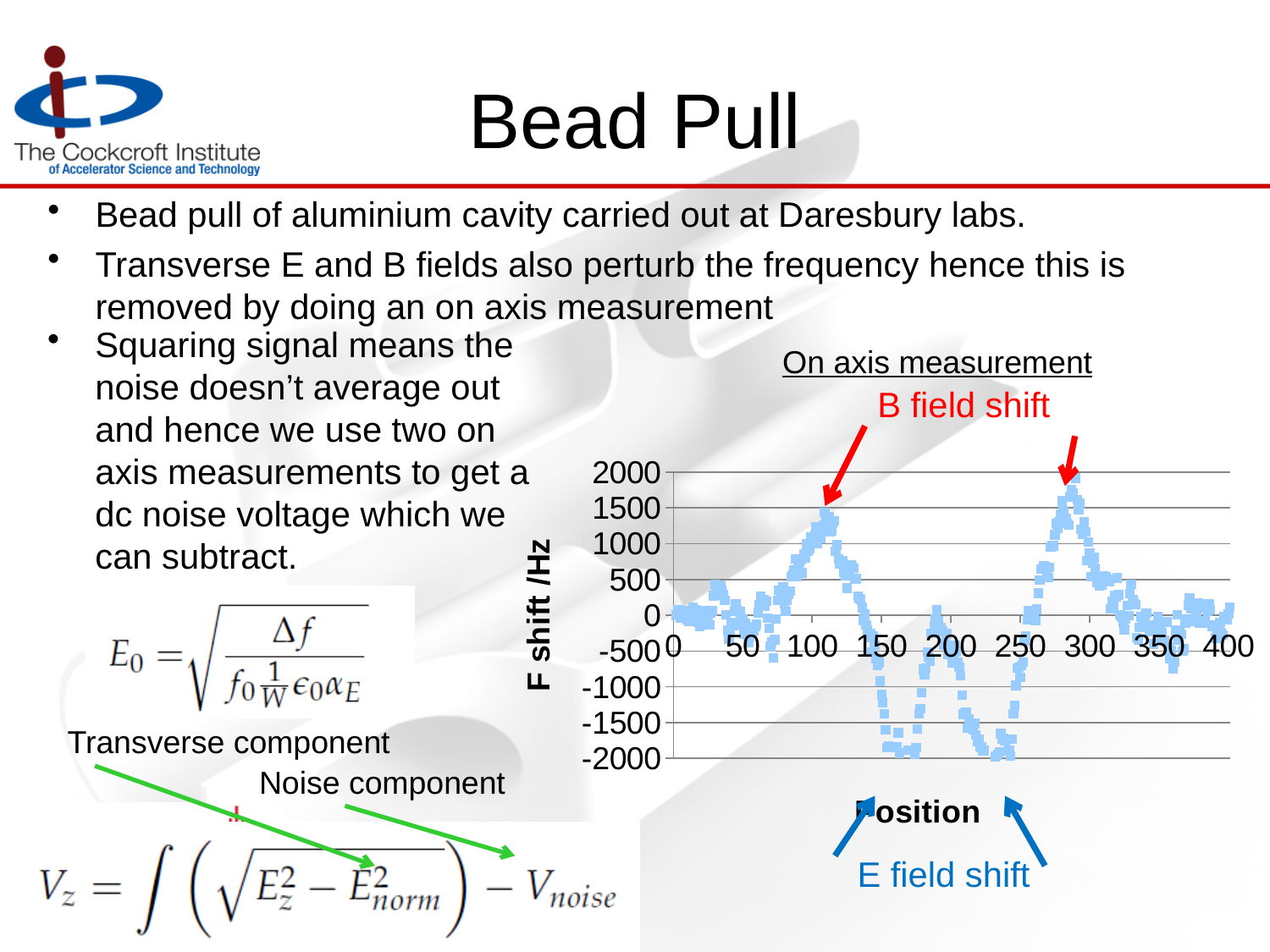
What is the maximum value shown on the y-axis of the 'On axis measurement' chart? 2000 What is the y-axis label of the 'On axis measurement' chart? F shift /Hz What is the title of the chart on the slide? On axis measurement What kind of chart is the 'On axis measurement' chart? scatter chart In the 'On axis measurement' chart, is the lowest F shift near position 150 greater or less than -1500 Hz? less In the 'On axis measurement' chart, is the lowest F shift near position 250 greater or less than -1000 Hz? less In the 'On axis measurement' chart, does the F shift rise or fall as position goes from 300 to 350? fall In the 'On axis measurement' chart, does the F shift rise or fall as position goes from 50 to 100? rise In the 'On axis measurement' chart, which positive peak is higher: the one near position 100 or the one near position 300? the one near position 300 In the 'On axis measurement' chart, is the peak F shift near position 100 greater or less than 1000 Hz? greater